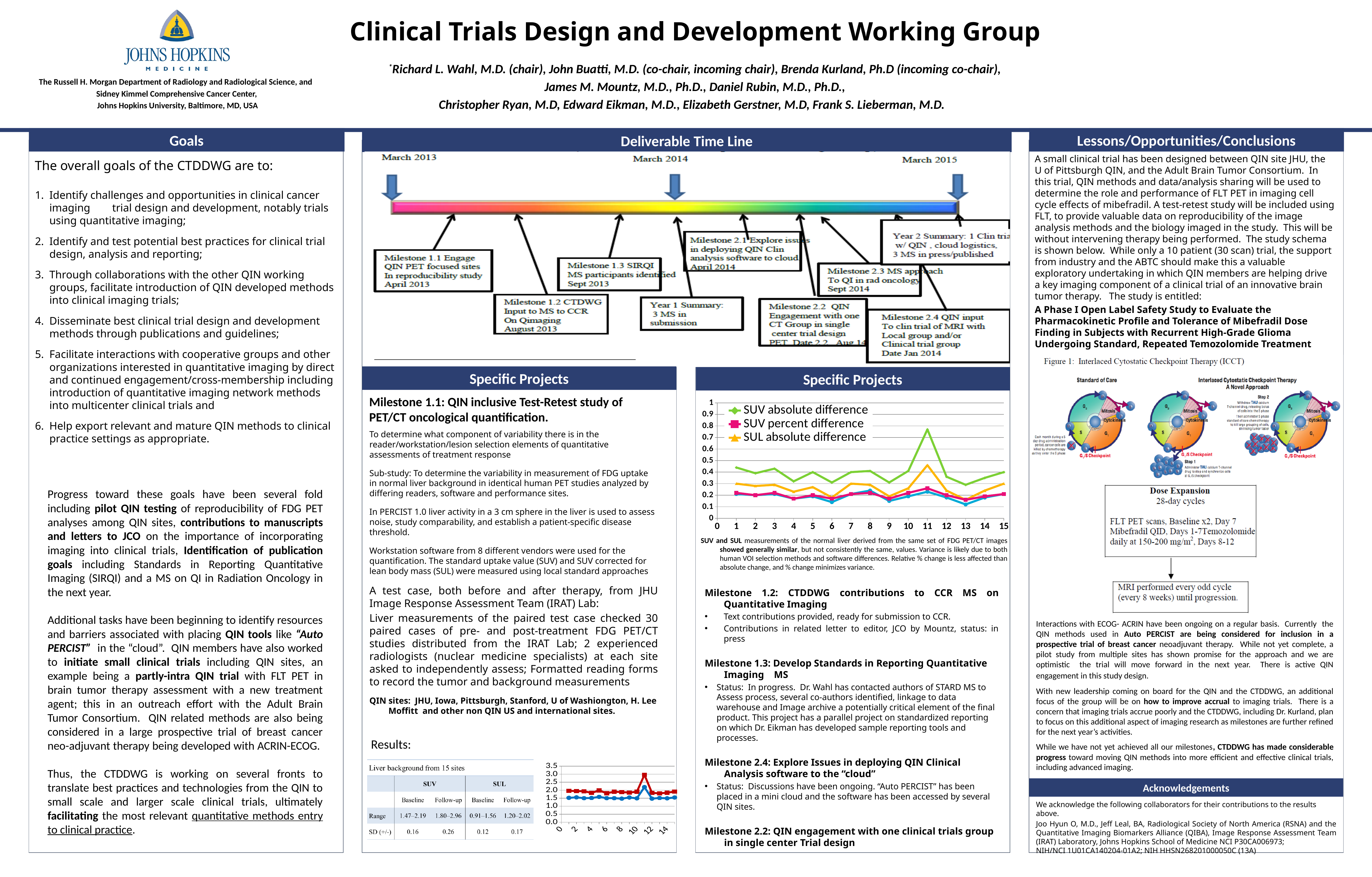
On the chart in the Specific Projects section with the SUV/SUL legend, which series has the higher value at x = 11: SUV absolute difference or SUL absolute difference? SUV absolute difference On the chart in the Specific Projects section with the SUV/SUL legend, what are the three legend entries? SUV absolute difference, SUV percent difference, SUL absolute difference On the chart in the Specific Projects section with the SUV/SUL legend, what colour is the SUV absolute difference line? green On the chart in the Specific Projects section with the SUV/SUL legend, is the SUV percent difference at x = 13 greater or less than 0.2? less On the chart in the Specific Projects section with the SUV/SUL legend, at which x value does the SUV absolute difference reach its highest point? 11 On the chart in the Specific Projects section with the SUV/SUL legend, what kind of chart is it? line chart On the chart in the Specific Projects section with the SUV/SUL legend, is the SUV absolute difference at x = 11 greater or less than 0.6? greater On the chart in the Specific Projects section with the SUV/SUL legend, how many series does the legend list? 3 On the chart in the Specific Projects section with the SUV/SUL legend, is the SUL absolute difference at x = 11 greater or less than 0.4? greater On the chart in the Specific Projects section with the SUV/SUL legend, what is the maximum value shown on the y axis? 1 On the chart in the Specific Projects section with the SUV/SUL legend, which series lies highest across the whole x axis? SUV absolute difference